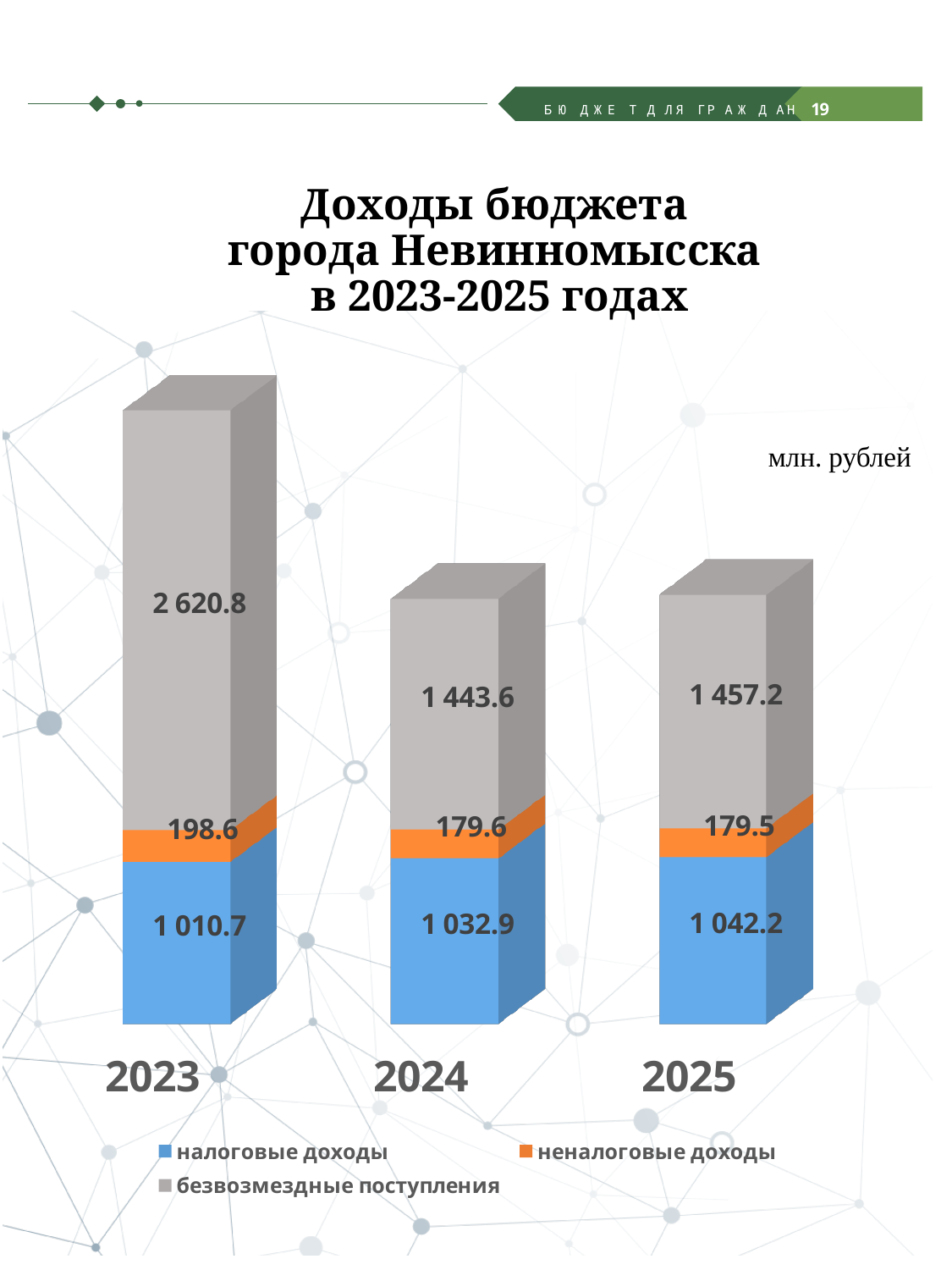
What is the difference between безвозмездные поступления in 2023 and 2024? 1 177.2 What is the value of безвозмездные поступления for 2023? 2 620.8 In which year are безвозмездные поступления the highest? 2023 What is the total of the stacked bar for 2025? 2 678.9 What type of chart is shown on the slide? stacked bar chart What is the total of the stacked bar for 2023? 3 830.1 What is the value of налоговые доходы for 2025? 1 042.2 What is the value of неналоговые доходы for 2024? 179.6 How many series does the legend list? 3 Which is larger: налоговые доходы in 2024 or in 2025? 2025 In which year are налоговые доходы the lowest? 2023 How many years (categories) are shown on the x axis? 3